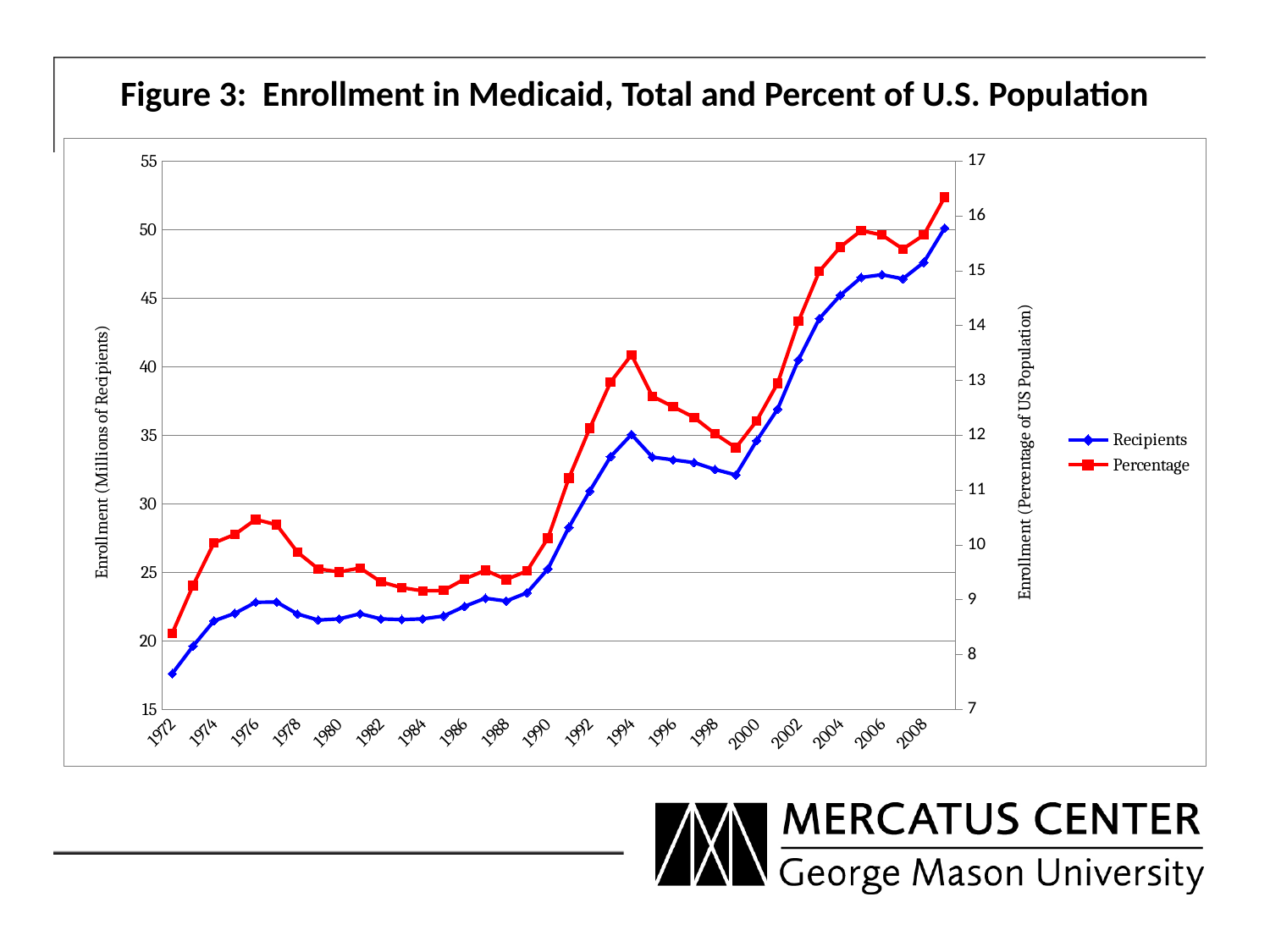
What are the two series named in the legend? Recipients and Percentage In which year is the Percentage series at its lowest? 1972 Is the value for Percentage in 1984 greater or less than 10? less What is the label of the left vertical axis? Enrollment (Millions of Recipients) Which is larger, the Recipients value in 1994 or in 1999? 1994 Is the value for Recipients in 1980 greater or less than 25? less Is the value for Percentage in 2009 greater or less than 16? greater What kind of chart is shown on the slide? line chart Overall, do the Recipients values rise or fall from 1972 to 2009? rise In which year is the Recipients series at its highest? 2009 How many series does the legend list? 2